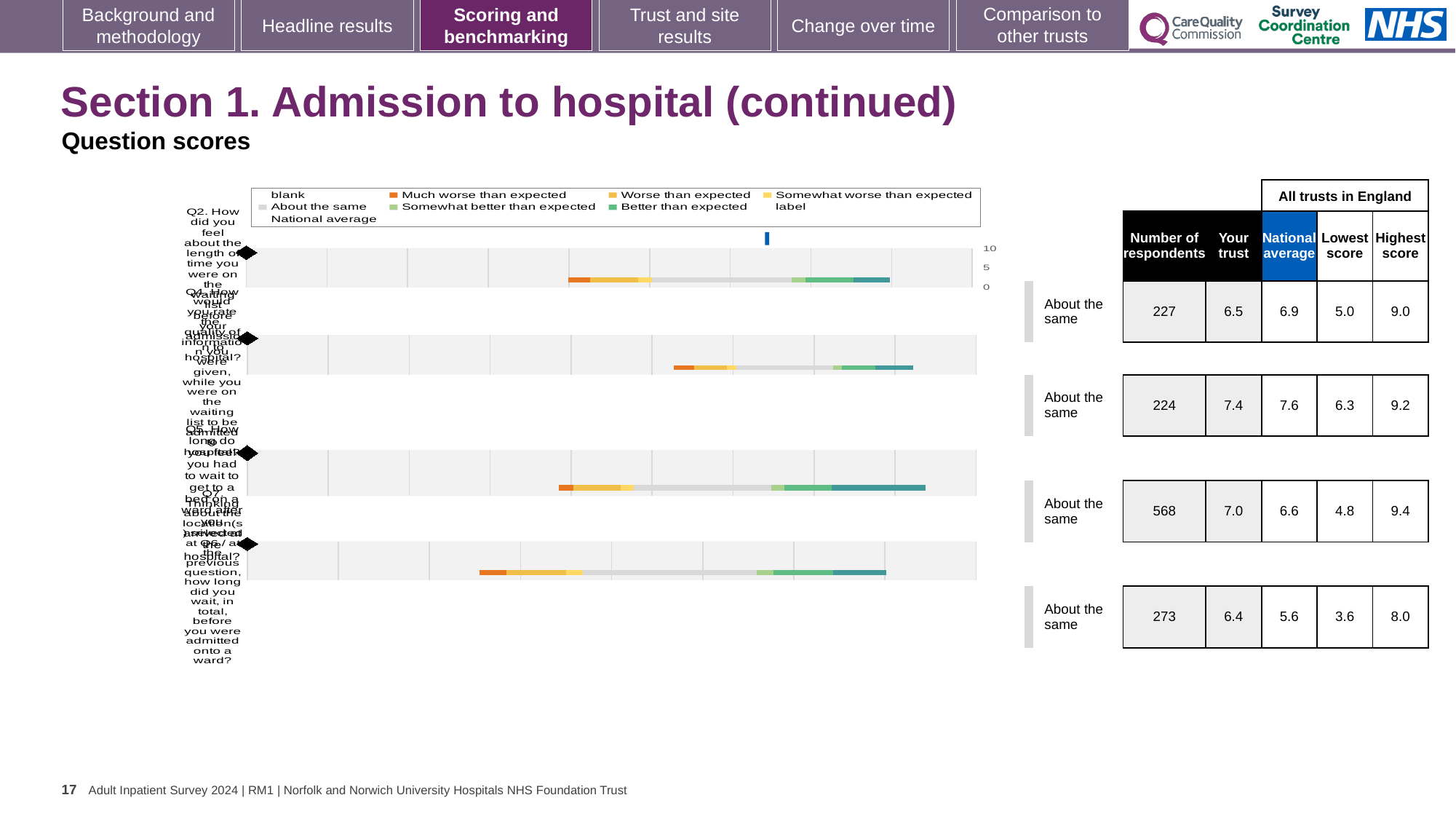
In the table beside the chart, what is the highest score for the fourth row? 8.0 In the table beside the chart, what is the 'Your trust' score for the first row (Q2)? 6.5 Which legend entry is shown in dark orange? Much worse than expected How many question rows are plotted in the chart? 4 What kind of chart is shown on the slide? bar chart In the table beside the chart, how many respondents are listed for the third row? 568 What is the maximum value shown on the chart's score axis? 10 In the table beside the chart, what is the national average for the second row? 7.6 In the table beside the chart, what is the difference between the 'Your trust' score and the national average in the fourth row? 0.8 In the table beside the chart, which row has the highest 'Your trust' score? the second row (7.4) In the table beside the chart, which row has the lowest 'Lowest score' value? the fourth row (3.6) In the table beside the chart, is the 'Your trust' score in the first row larger or smaller than the national average? smaller